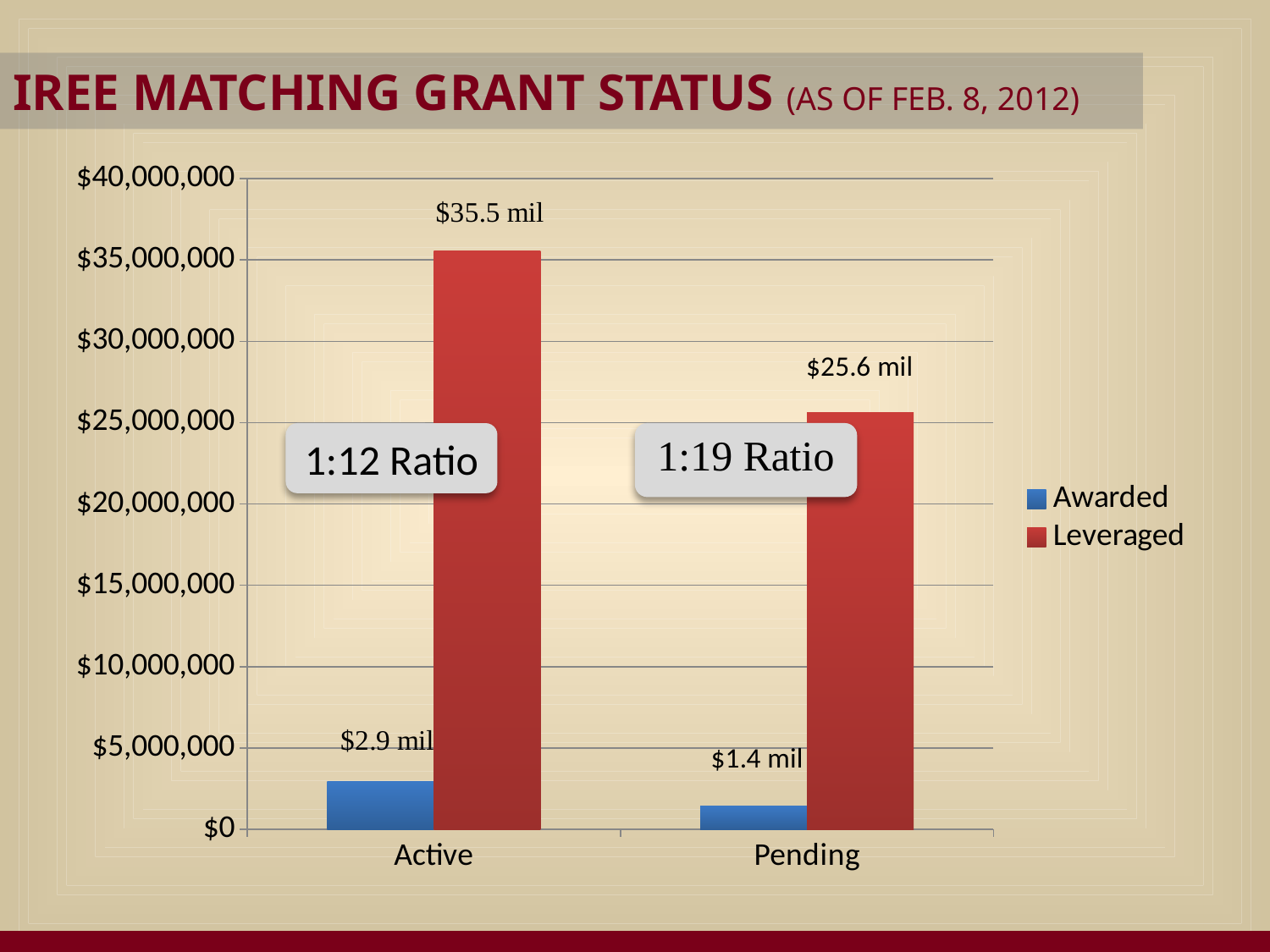
Which category has the higher Leveraged value, Active or Pending? Active What is the difference between the Awarded values for Active and Pending? $1.5 mil What is the Awarded value for Pending? $1.4 mil What is the Awarded value for Active? $2.9 mil What is the difference between the Leveraged values for Active and Pending? $9.9 mil How many categories are shown on the x axis? 2 How many series does the legend list? 2 What is the Leveraged value for Active? $35.5 mil What kind of chart is shown on the slide? bar chart What is the Leveraged value for Pending? $25.6 mil Is the Leveraged value for Pending greater or less than $30,000,000? less Which category has the lowest Awarded value? Pending